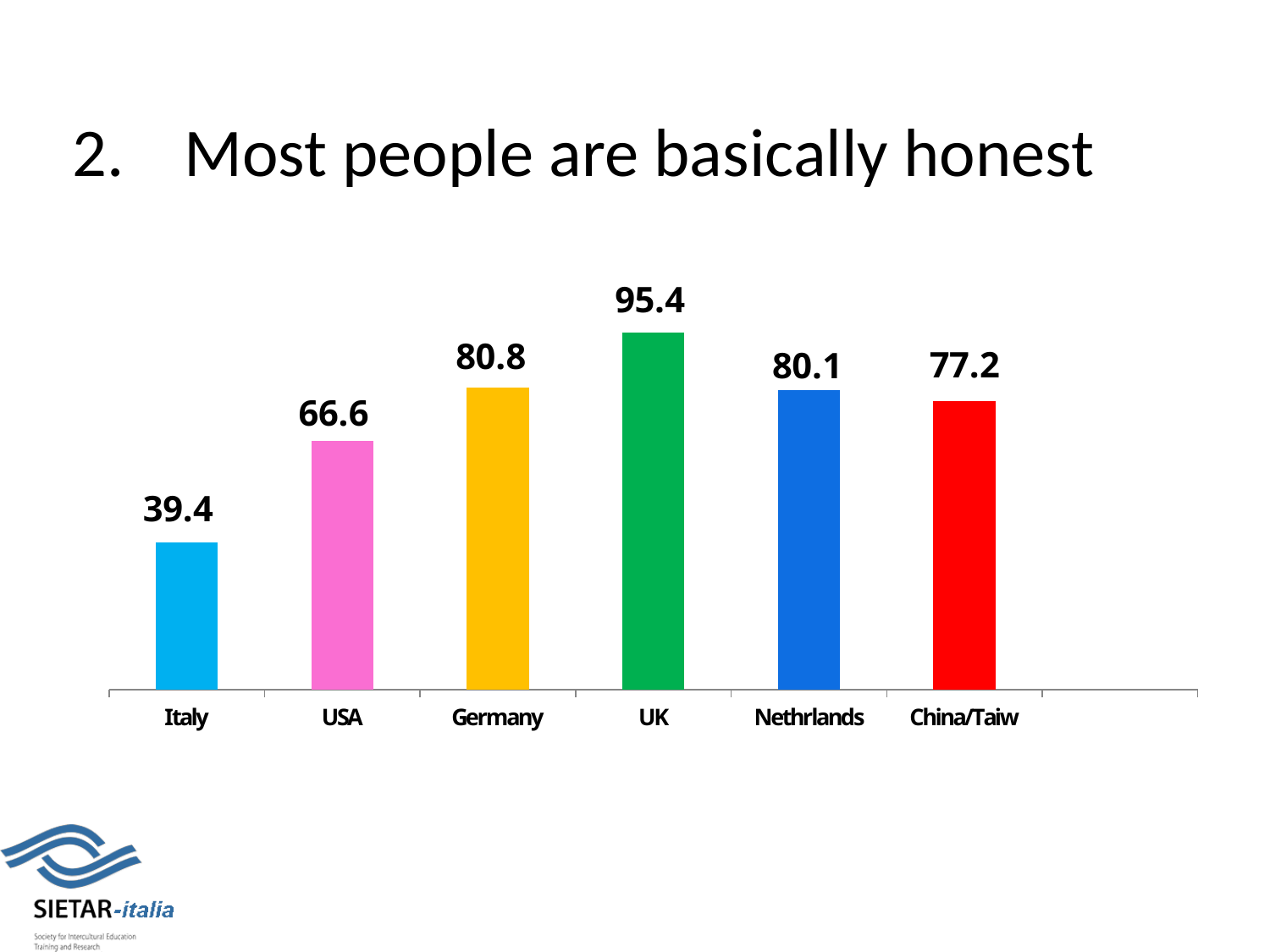
What is the title of the slide? 2. Most people are basically honest What is the value for Germany? 80.8 What is the value for the UK? 95.4 How many countries are shown in the chart? 6 Which is larger, the value for the USA or the value for Nethrlands? Nethrlands What is the value for China/Taiw? 77.2 What is the difference between the values for the UK and Italy? 56.0 What kind of chart is shown on the slide? Bar chart What is the value for Italy? 39.4 Which country has the highest value? UK What is the difference between the values for Germany and the USA? 14.2 Which country has the lowest value? Italy